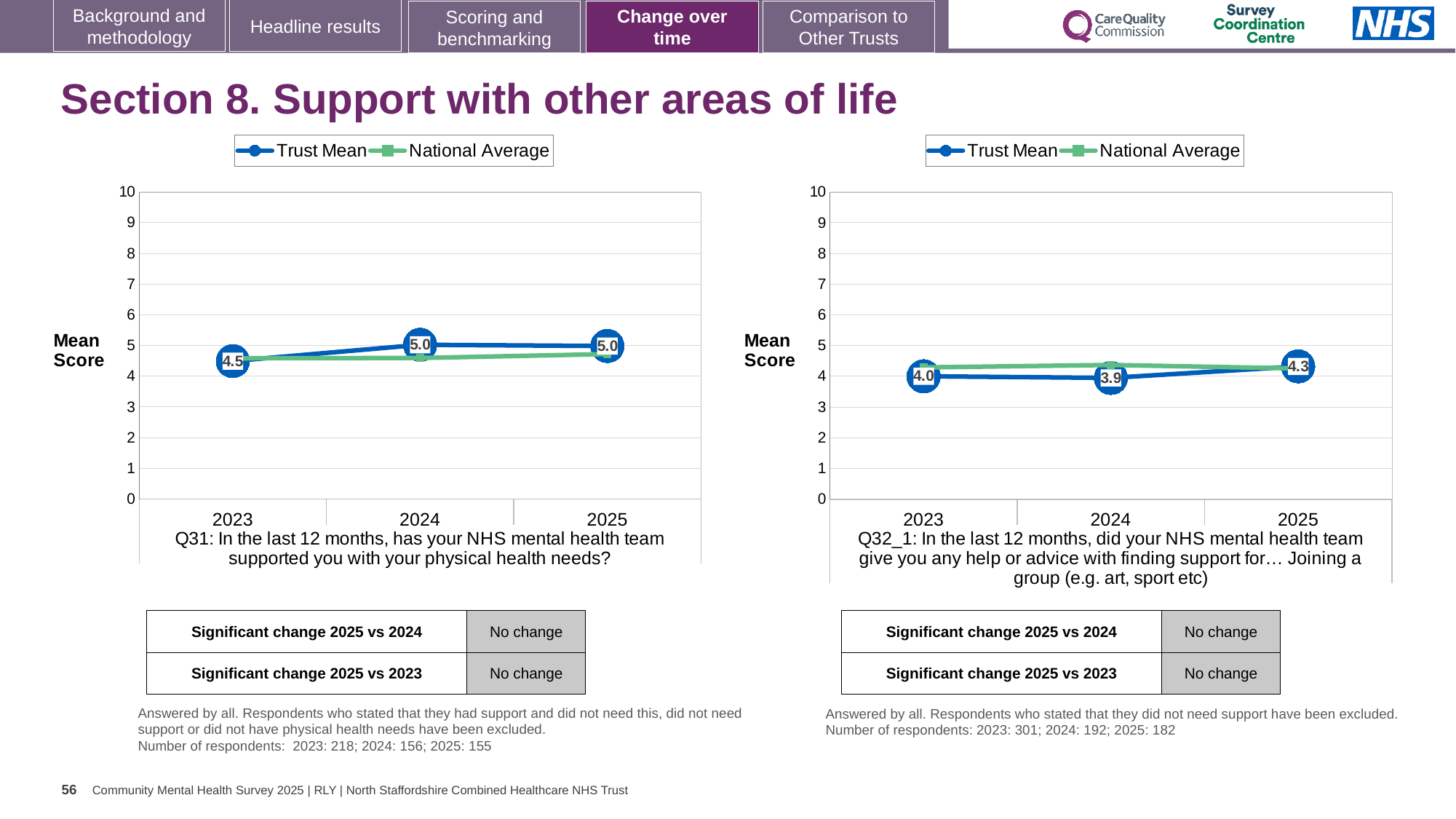
On the right chart (Q32_1), is the Trust Mean for 2023 greater or less than 5? less On the left chart (Q31), what is the Trust Mean for 2023? 4.5 On the left chart (Q31), what is the difference between the Trust Mean for 2024 and 2023? 0.5 On the right chart (Q32_1), what is the Trust Mean for 2025? 4.3 On the left chart (Q31), which year has the lowest Trust Mean? 2023 On the left chart (Q31), what is the Trust Mean for 2025? 5.0 On the right chart (Q32_1), which year has the lowest Trust Mean? 2024 On the right chart (Q32_1), what is the Trust Mean for 2024? 3.9 What kind of chart is the right chart (Q32_1)? line chart How many series does the legend of the left chart (Q31) list? 2 On the left chart (Q31), does the Trust Mean rise or fall from 2023 to 2024? rise On the right chart (Q32_1), what is the difference between the Trust Mean for 2025 and 2024? 0.4